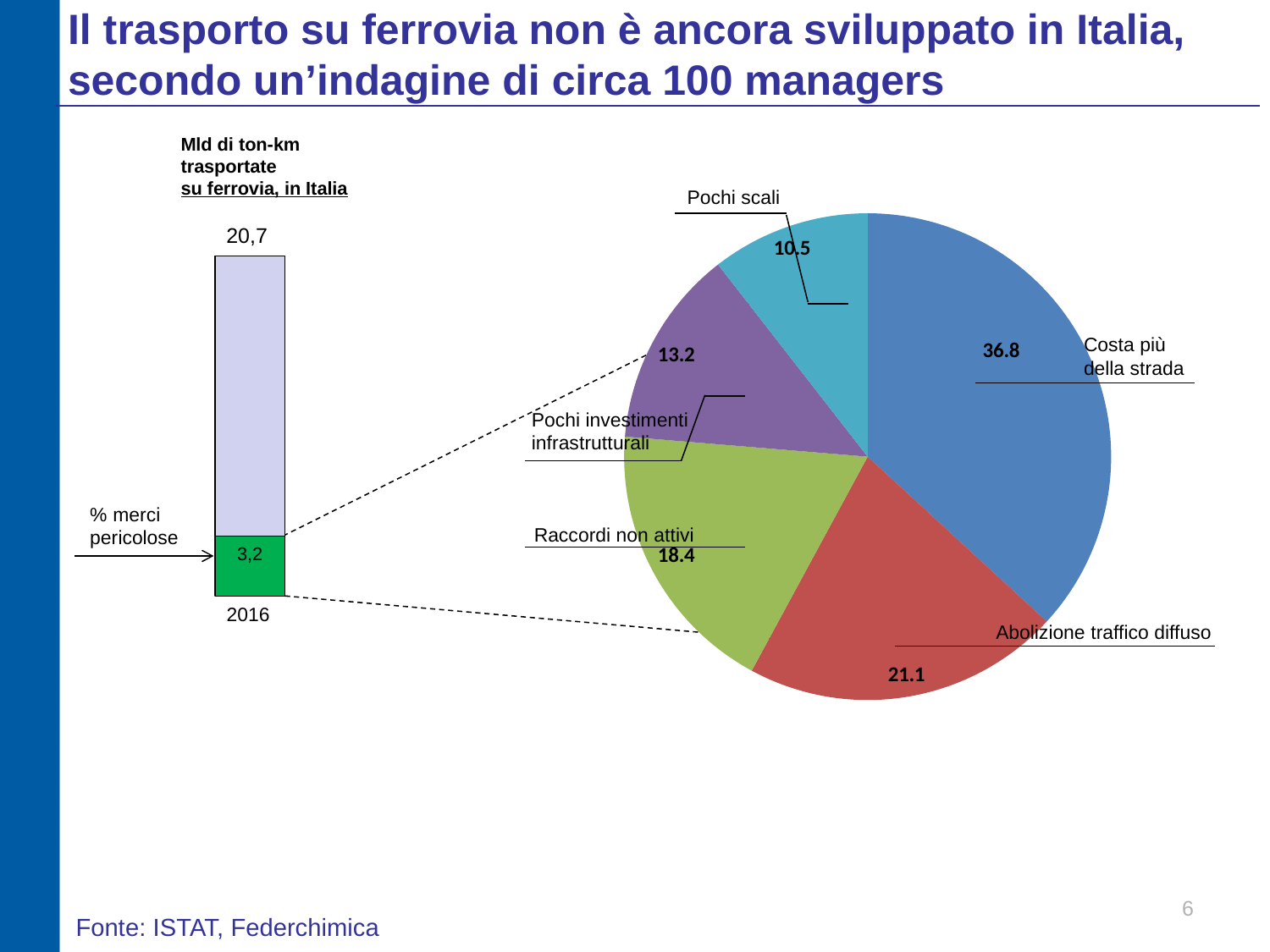
What kind of chart is shown on the right of the slide? Pie chart In the pie chart on the right, what is the value for "Raccordi non attivi"? 18.4 In the pie chart on the right, what is the difference between "Abolizione traffico diffuso" and "Pochi investimenti infrastrutturali"? 7.9 In the pie chart on the right, which slice is the largest? Costa più della strada How many slices does the pie chart on the right have? 5 In the pie chart on the right, which slice is the smallest? Pochi scali In the bar chart on the left, what is the value of the "% merci pericolose" segment? 3,2 In the pie chart on the right, what is the value for "Pochi scali"? 10.5 In the pie chart on the right, what is the value for "Costa più della strada"? 36.8 In the bar chart on the left (Mld di ton-km trasportate su ferrovia, in Italia), what is the total value of the bar for 2016? 20,7 In the pie chart on the right, which is larger: "Raccordi non attivi" or "Pochi investimenti infrastrutturali"? Raccordi non attivi What kind of chart is shown on the left of the slide? Bar chart